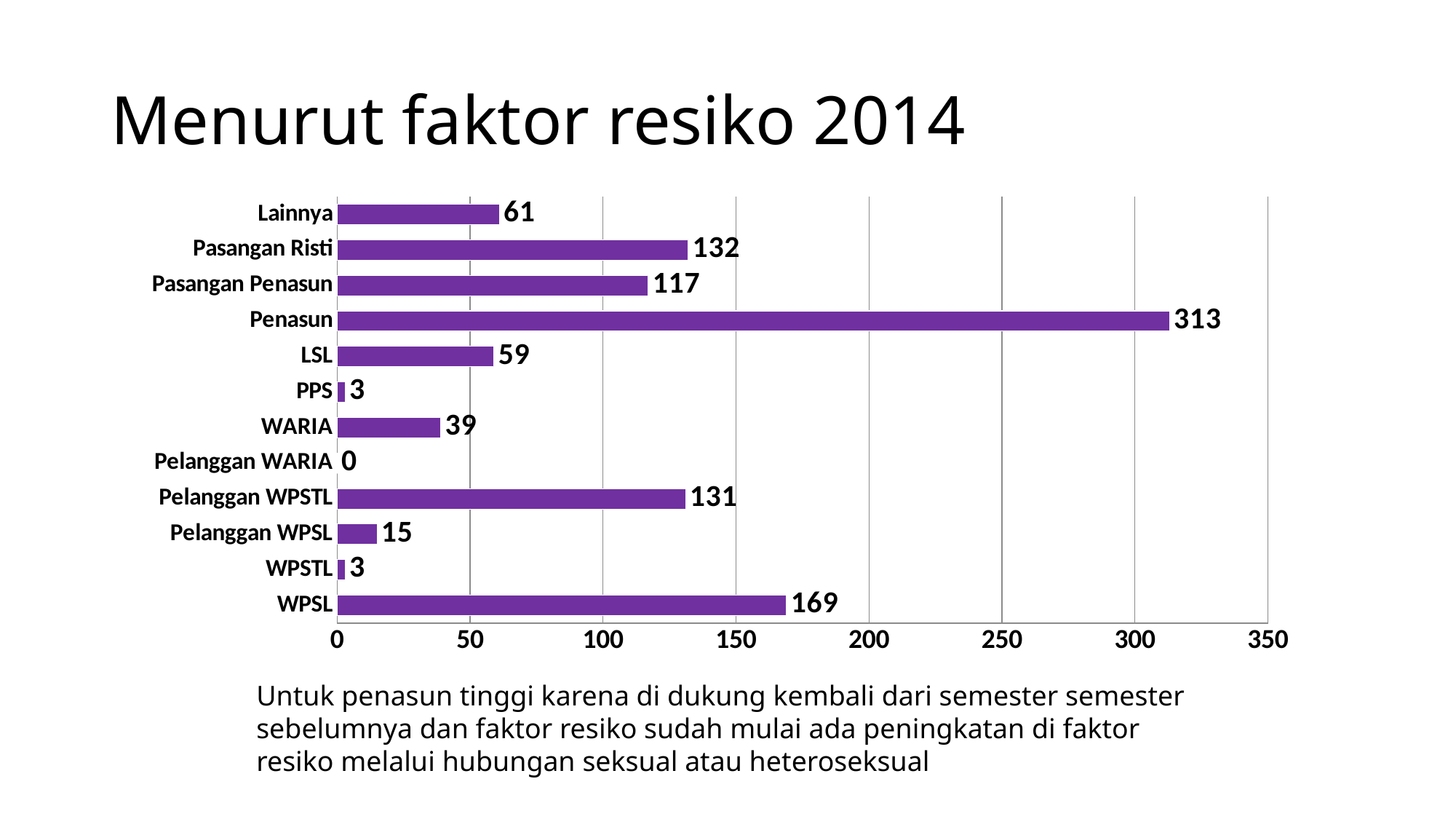
How many categories are shown in the chart? 12 What kind of chart is shown on the slide? bar chart What is the difference between the values for WPSL and Pasangan Risti? 37 Is the value for Pasangan Penasun greater or less than 100? greater Which is larger, the value for Lainnya or the value for LSL? Lainnya Which category has the highest value? Penasun What is the value for WARIA? 39 What is the difference between the values for Penasun and Pasangan Penasun? 196 What is the value for Penasun? 313 What is the value for Pelanggan WPSTL? 131 What is the title of the slide? Menurut faktor resiko 2014 Which category has the lowest value? Pelanggan WARIA